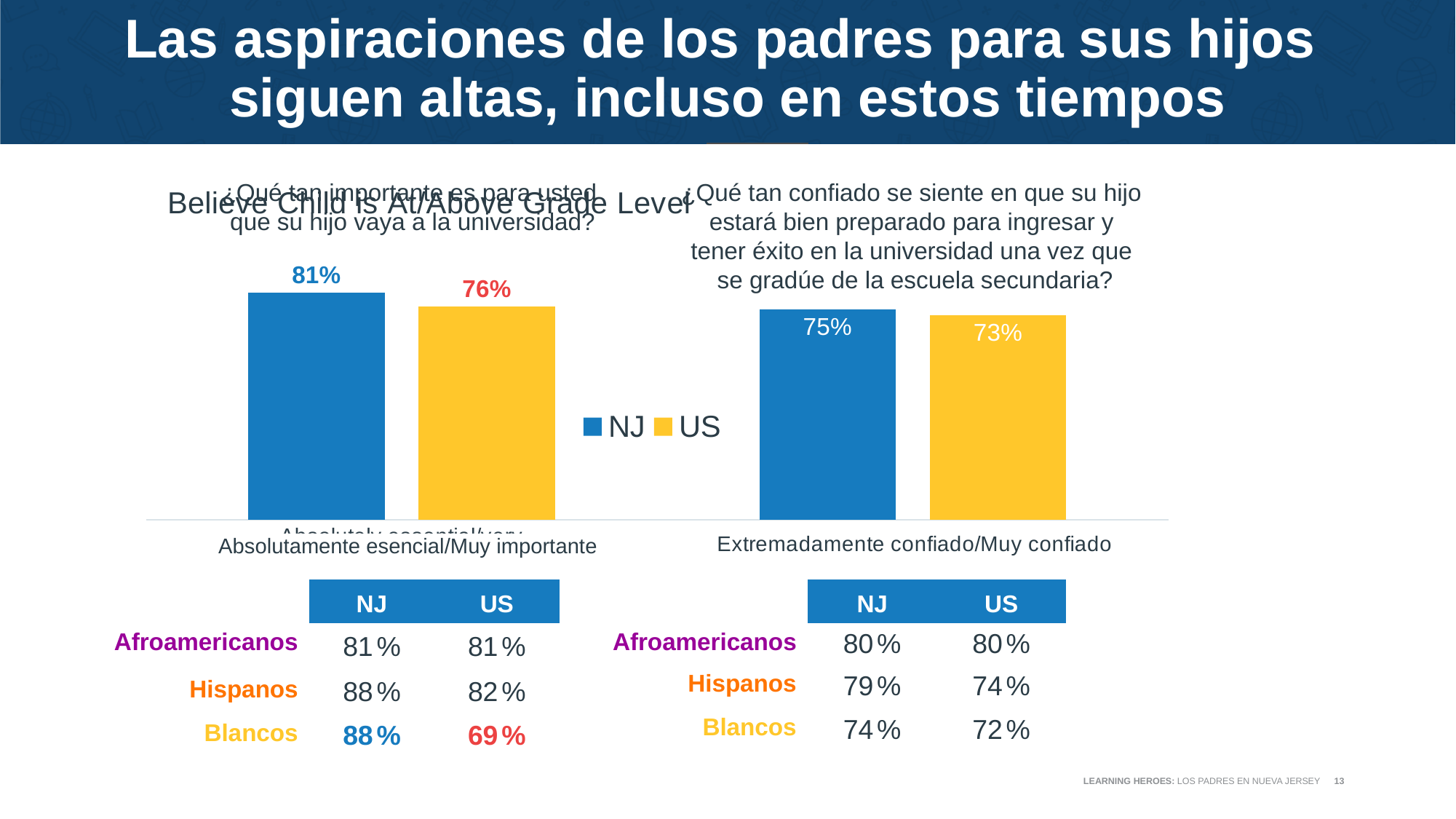
What kind of chart is shown on the slide? Bar chart What is the US value for "Absolutamente esencial/Muy importante"? 76% What is the NJ value for "Absolutamente esencial/Muy importante"? 81% For "Absolutamente esencial/Muy importante", which is larger, the NJ value or the US value? NJ What is the difference between the NJ and US values for "Extremadamente confiado/Muy confiado"? 2 percentage points Which colour represents the US series in the chart legend? Yellow How many series does the chart legend list? 2 What is the US value for "Extremadamente confiado/Muy confiado"? 73% Which bar in the chart has the highest value? NJ for Absolutamente esencial/Muy importante (81%) Which bar in the chart has the lowest value? US for Extremadamente confiado/Muy confiado (73%) What is the NJ value for "Extremadamente confiado/Muy confiado"? 75% What is the difference between the NJ and US values for "Absolutamente esencial/Muy importante"? 5 percentage points